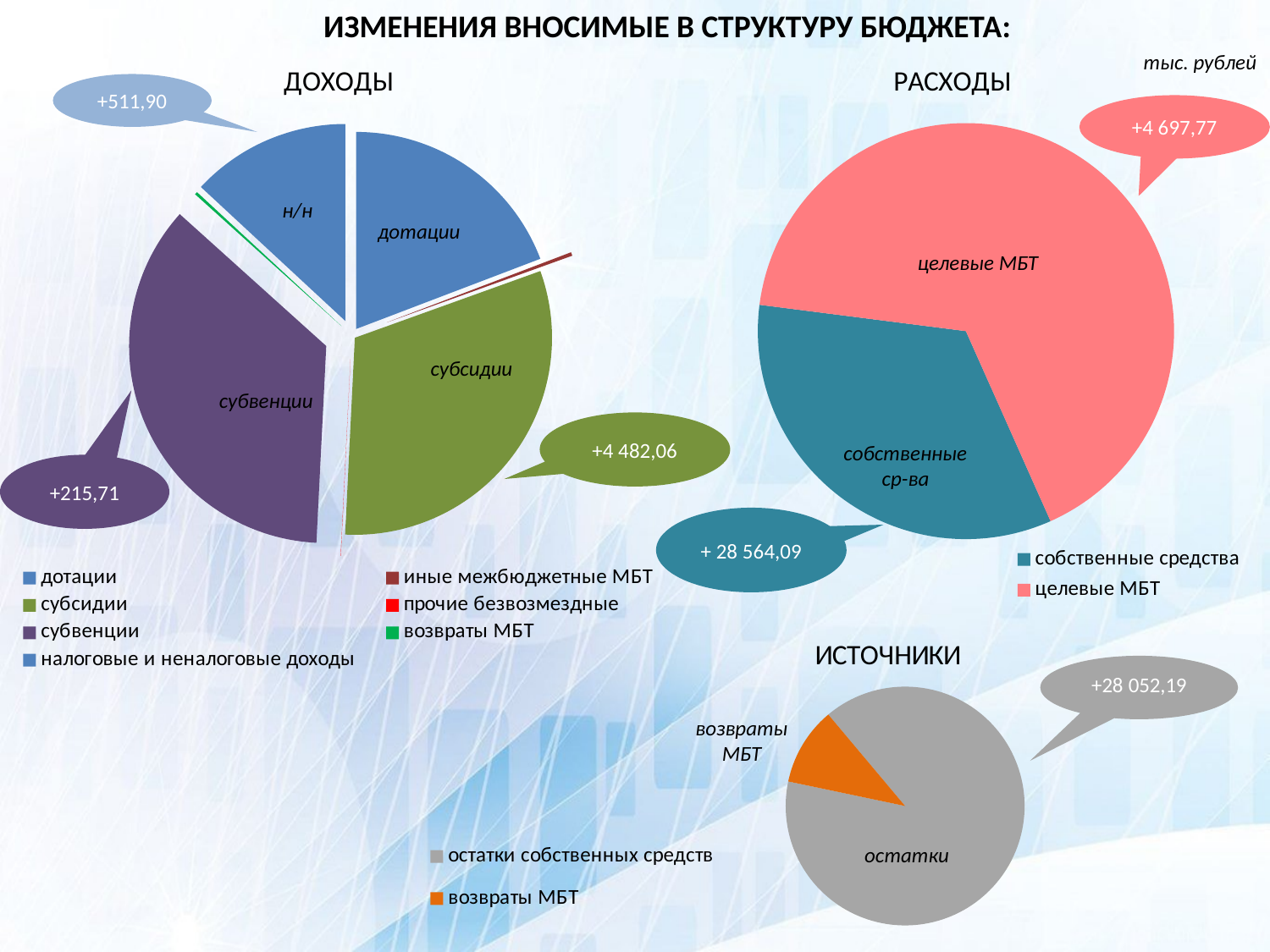
In the РАСХОДЫ chart, what change value is shown in the callout pointing to the собственные ср-ва slice? + 28 564,09 How many entries does the legend of the РАСХОДЫ chart list? 2 In the РАСХОДЫ chart, which slice is larger: целевые МБТ or собственные средства? целевые МБТ In the ИСТОЧНИКИ chart, what change value is shown in the callout pointing to the остатки slice? +28 052,19 In the ИСТОЧНИКИ chart, which slice is the smallest? возвраты МБТ In the ДОХОДЫ chart, what change value is shown in the callout pointing to the субсидии slice? +4 482,06 What kind of chart is the ДОХОДЫ chart? pie chart In the ДОХОДЫ chart, what change value is shown in the callout pointing to the субвенции slice? +215,71 In the ИСТОЧНИКИ chart, which slice is the largest? остатки собственных средств How many slices does the ИСТОЧНИКИ chart have? 2 How many entries does the legend of the ДОХОДЫ chart list? 7 What kind of chart is the ИСТОЧНИКИ chart? pie chart